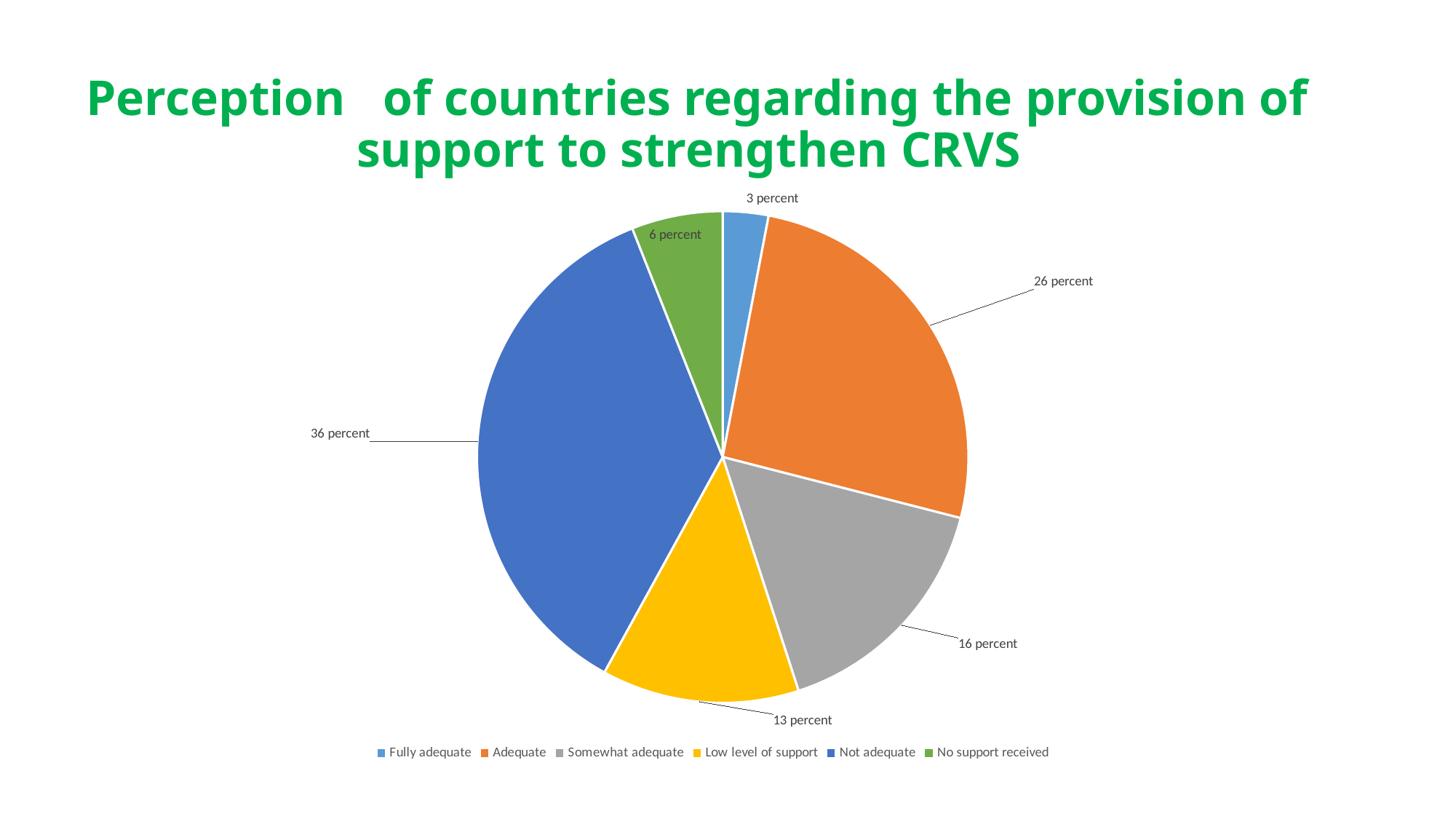
What colour is the slice for Low level of support? yellow Which category has the largest slice? Not adequate Which is larger, Somewhat adequate or Low level of support? Somewhat adequate Which category has the smallest slice? Fully adequate What is the value for Adequate? 26 percent What is the value for Not adequate? 36 percent What is the difference between the values for Somewhat adequate and Low level of support? 3 percent How many categories does the pie chart have? 6 What kind of chart is shown on the slide? pie chart What is the value for No support received? 6 percent What is the value for Fully adequate? 3 percent What is the difference between the values for Not adequate and Adequate? 10 percent